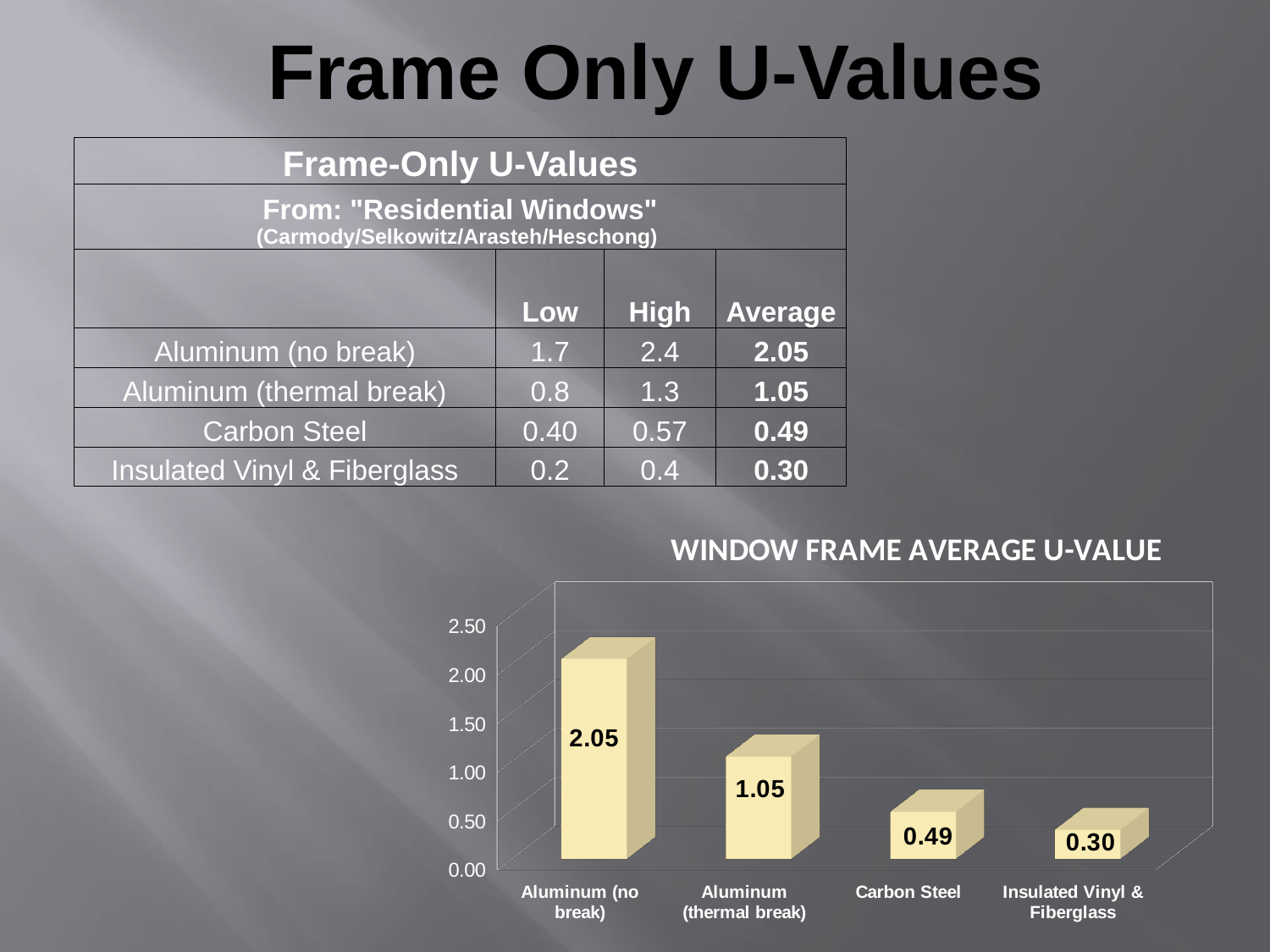
What is the average U-value shown for Aluminum (no break) in the chart? 2.05 What is the difference between the average U-values of Carbon Steel and Insulated Vinyl & Fiberglass? 0.19 What is the average U-value shown for Carbon Steel in the chart? 0.49 Which has a larger average U-value, Aluminum (thermal break) or Carbon Steel? Aluminum (thermal break) Is the value for Aluminum (no break) greater or less than 2.00? greater What kind of chart is shown on the slide? bar chart Which frame type has the lowest average U-value in the chart? Insulated Vinyl & Fiberglass How many frame types are plotted in the chart? 4 What is the difference between the average U-values of Aluminum (no break) and Aluminum (thermal break)? 1.00 What is the title of the chart? WINDOW FRAME AVERAGE U-VALUE What is the average U-value shown for Insulated Vinyl & Fiberglass in the chart? 0.30 Which frame type has the highest average U-value in the chart? Aluminum (no break)